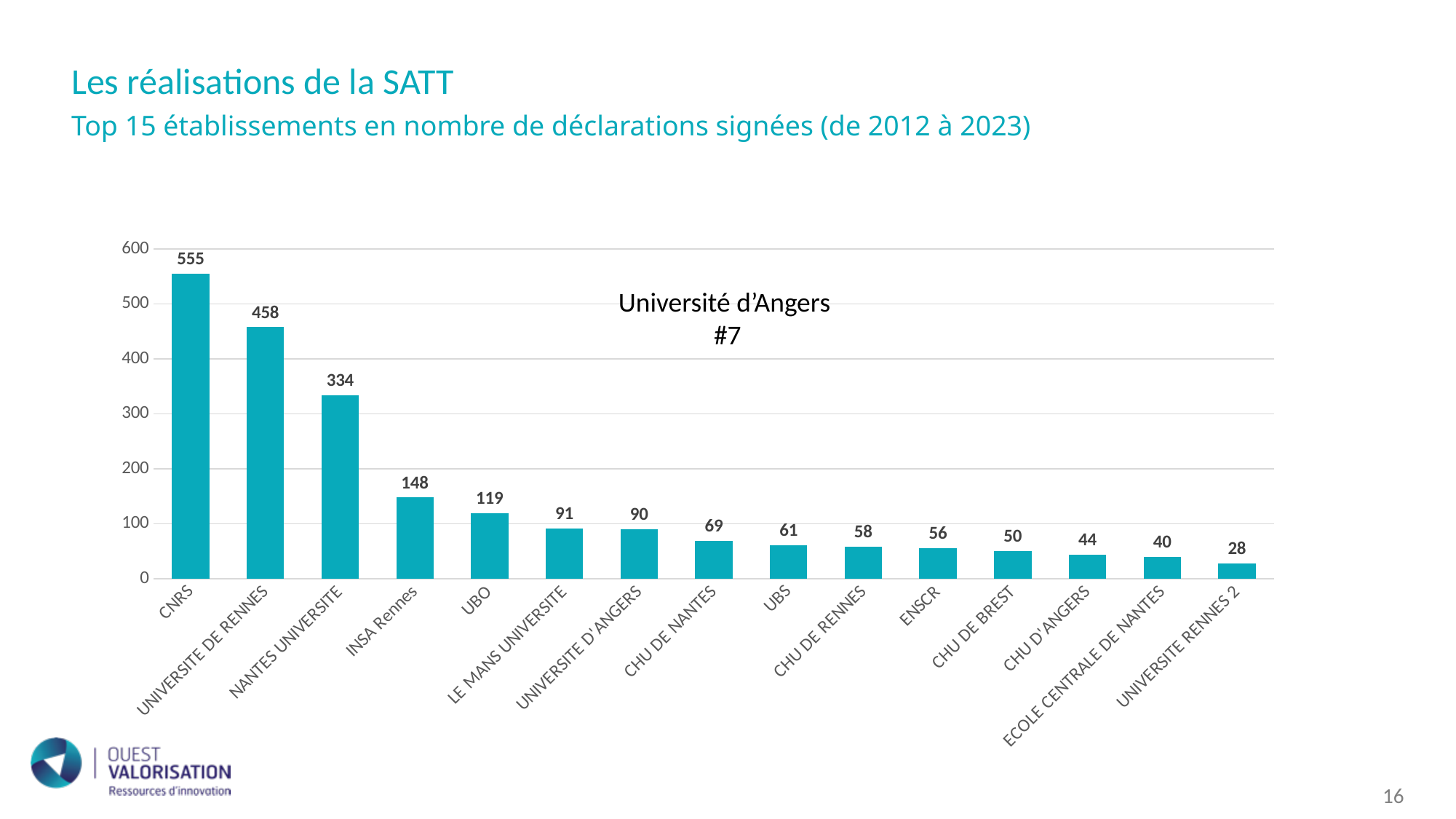
What kind of chart is shown on the slide? Bar chart What is the value for CNRS? 555 What rank is given for Université d'Angers in the annotation on the chart? #7 What is the difference between the values for INSA Rennes and UBO? 29 Which establishment has the lowest number of signed declarations? UNIVERSITE RENNES 2 How many establishments are shown in the chart? 15 Which is larger, the value for UBS or the value for CHU DE NANTES? CHU DE NANTES Is the value for NANTES UNIVERSITE greater or less than 300? greater What is the value for UNIVERSITE D'ANGERS? 90 Which establishment has the highest number of signed declarations? CNRS What is the value for CHU DE BREST? 50 What is the difference between the values for CNRS and UNIVERSITE DE RENNES? 97